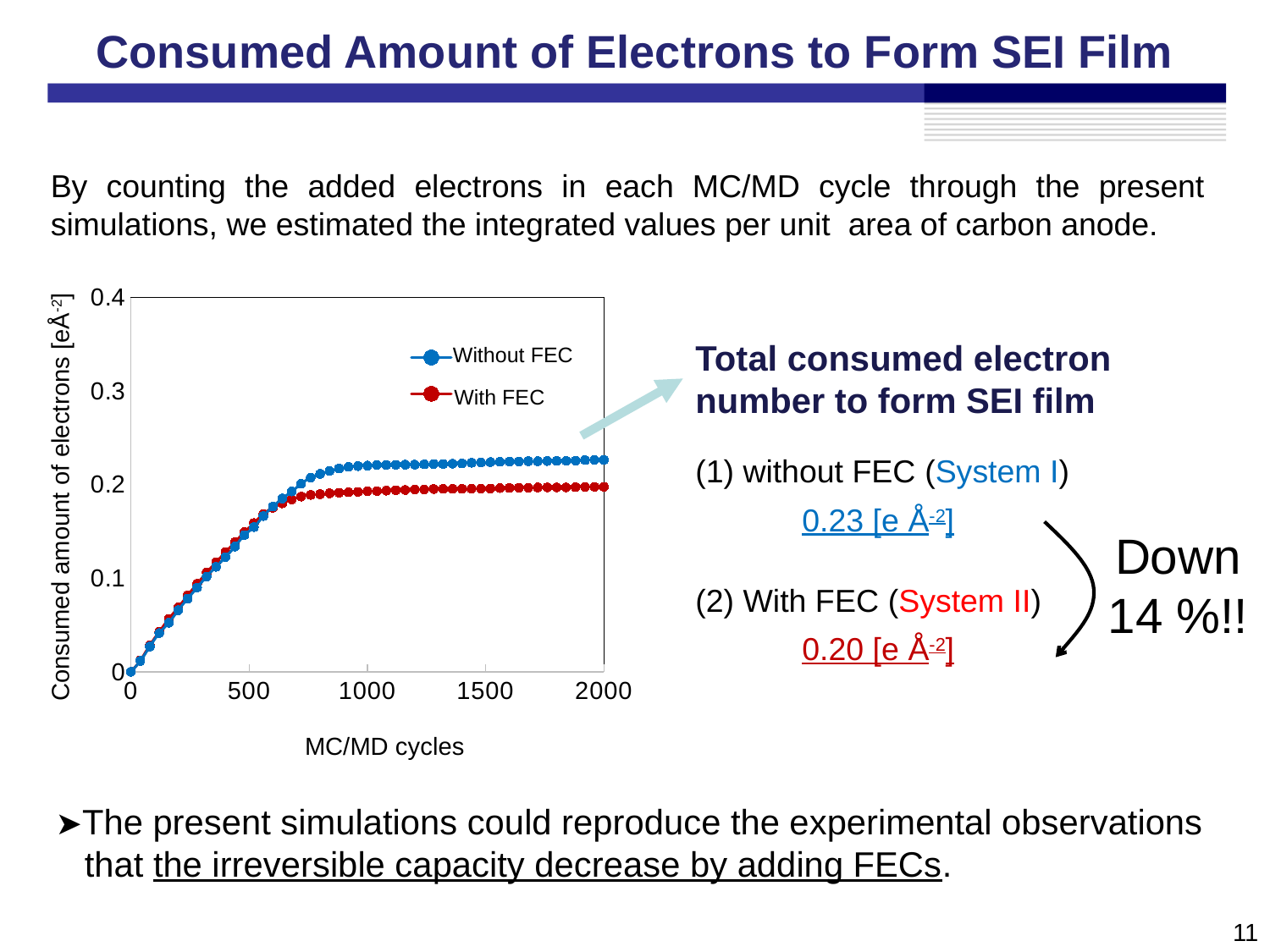
What are the two series named in the chart legend? Without FEC and With FEC Is the value for Without FEC at 2000 MC/MD cycles greater or less than 0.2? greater According to the slide, what is the total consumed electron number to form the SEI film without FEC (System I)? 0.23 [e Å-2] How many series does the chart legend list? 2 Is the value for Without FEC at 500 MC/MD cycles greater or less than 0.1? greater At 2000 MC/MD cycles, which series has the higher consumed amount of electrons, Without FEC or With FEC? Without FEC Do the consumed amount of electrons values rise or fall as the MC/MD cycles increase from 0 to 2000? rise What kind of chart is shown on the slide? line chart Is the value for With FEC at 2000 MC/MD cycles greater or less than 0.3? less What is the label of the x axis of the chart? MC/MD cycles According to the slide, what is the total consumed electron number to form the SEI film with FEC (System II)? 0.20 [e Å-2] Which series reaches the highest consumed amount of electrons in the chart? Without FEC